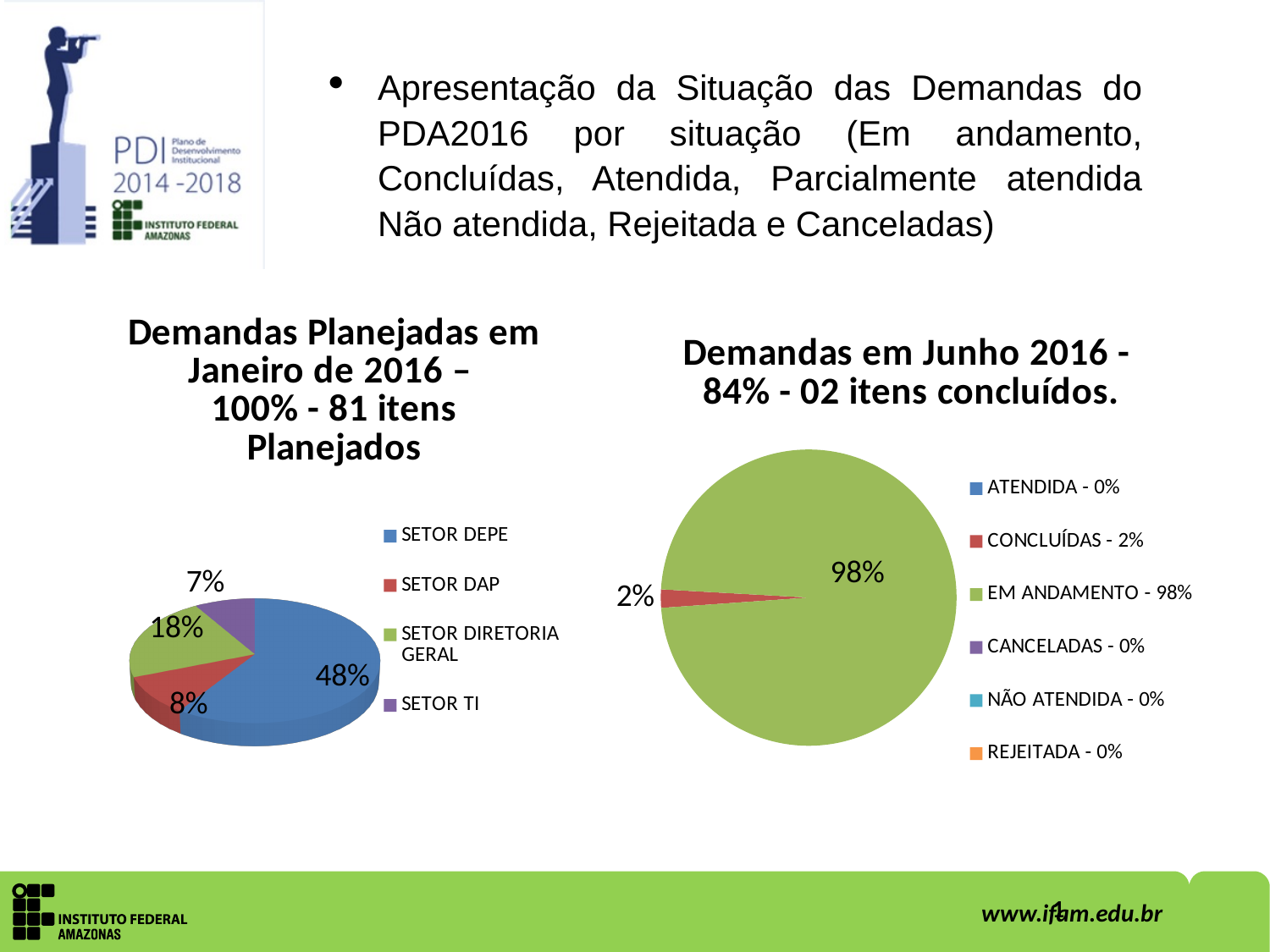
In the left chart 'Demandas Planejadas em Janeiro de 2016', what share is shown for SETOR DIRETORIA GERAL? 18% In the right chart 'Demandas em Junho 2016', what share is shown for EM ANDAMENTO? 98% In the left chart 'Demandas Planejadas em Janeiro de 2016', how many sectors does the legend list? 4 What kind of chart is the 'Demandas Planejadas em Janeiro de 2016' chart on the left? Pie chart In the left chart 'Demandas Planejadas em Janeiro de 2016', what share is shown for SETOR TI? 7% In the right chart 'Demandas em Junho 2016', how many categories does the legend list? 6 In the left chart 'Demandas Planejadas em Janeiro de 2016', which sector has the largest slice? SETOR DEPE In the left chart 'Demandas Planejadas em Janeiro de 2016', which sector has the smallest slice? SETOR TI In the left chart 'Demandas Planejadas em Janeiro de 2016', what is the difference between the SETOR DEPE share and the SETOR DAP share? 40% In the right chart 'Demandas em Junho 2016', which category is larger, CONCLUÍDAS or EM ANDAMENTO? EM ANDAMENTO